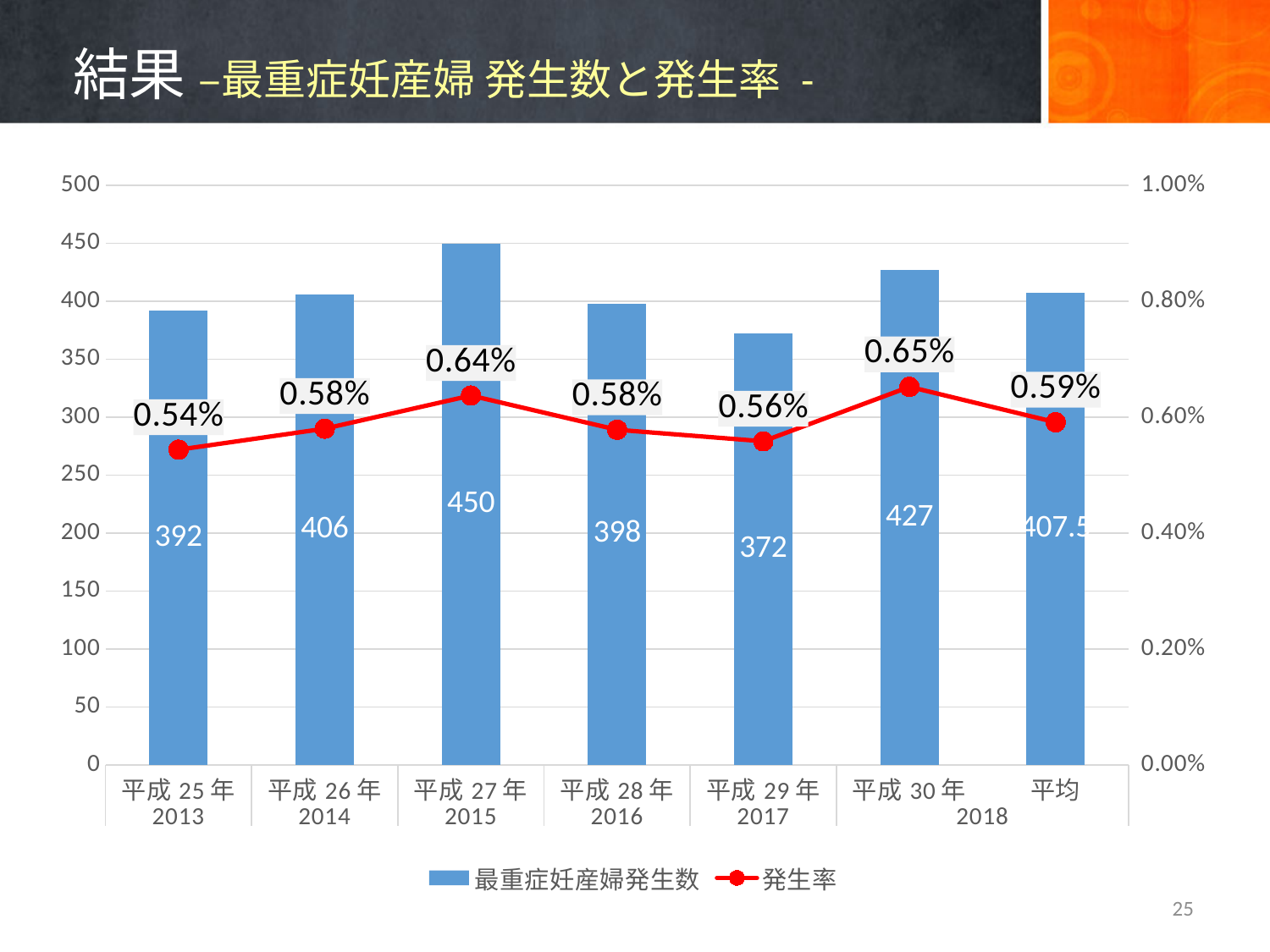
How many categories are shown on the x axis? 7 Which year has the lowest 最重症妊産婦発生数? 平成 29 年 2017 What kind of chart is shown on the slide? Combined bar and line chart What is the 発生率 for 平成 30 年 2018? 0.65% Which is larger, the 最重症妊産婦発生数 for 平成 26 年 2014 or for 平成 28 年 2016? 平成 26 年 2014 What is the value of 最重症妊産婦発生数 for 平均? 407.5 How many series does the legend list? 2 Is the 最重症妊産婦発生数 for 平成 30 年 2018 greater or less than 400? greater What is the value of 最重症妊産婦発生数 for 平成 27 年 2015? 450 What is the 発生率 for 平成 25 年 2013? 0.54% What is the difference in 最重症妊産婦発生数 between 平成 27 年 2015 and 平成 29 年 2017? 78 Which category has the highest 発生率? 平成 30 年 2018